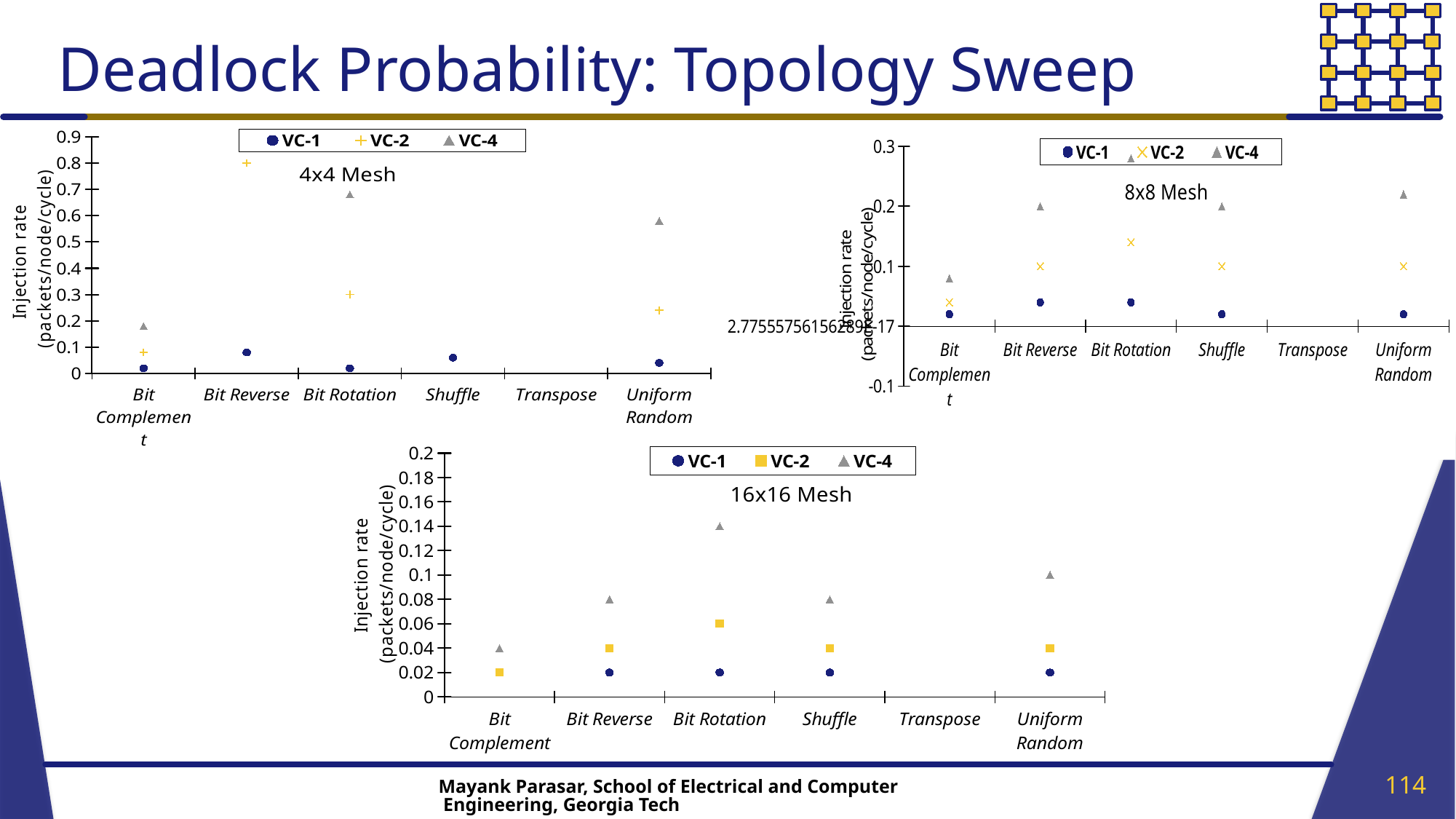
Which traffic pattern has no plotted points in any of the three charts? Transpose In the 16x16 Mesh chart, which is larger for Uniform Random: the VC-4 value or the VC-2 value? VC-4 How many traffic pattern categories are shown on the x axis of the 8x8 Mesh chart? 6 In the 4x4 Mesh chart, is the VC-4 value for Bit Rotation greater or less than 0.6? greater In the 16x16 Mesh chart, what is the difference between the VC-4 and VC-2 injection rates for Bit Rotation? 0.08 What kind of chart is the 4x4 Mesh chart? scatter chart In the 8x8 Mesh chart, which traffic pattern has the highest VC-4 injection rate? Bit Rotation In the 4x4 Mesh chart, what is the VC-2 injection rate for Bit Rotation? 0.3 In the 4x4 Mesh chart, what is the VC-2 injection rate for Bit Reverse? 0.8 In the 16x16 Mesh chart, what is the VC-4 injection rate for Bit Rotation? 0.14 In the 8x8 Mesh chart, what is the VC-4 injection rate for Bit Reverse? 0.2 How many series does the legend of the 16x16 Mesh chart list? 3